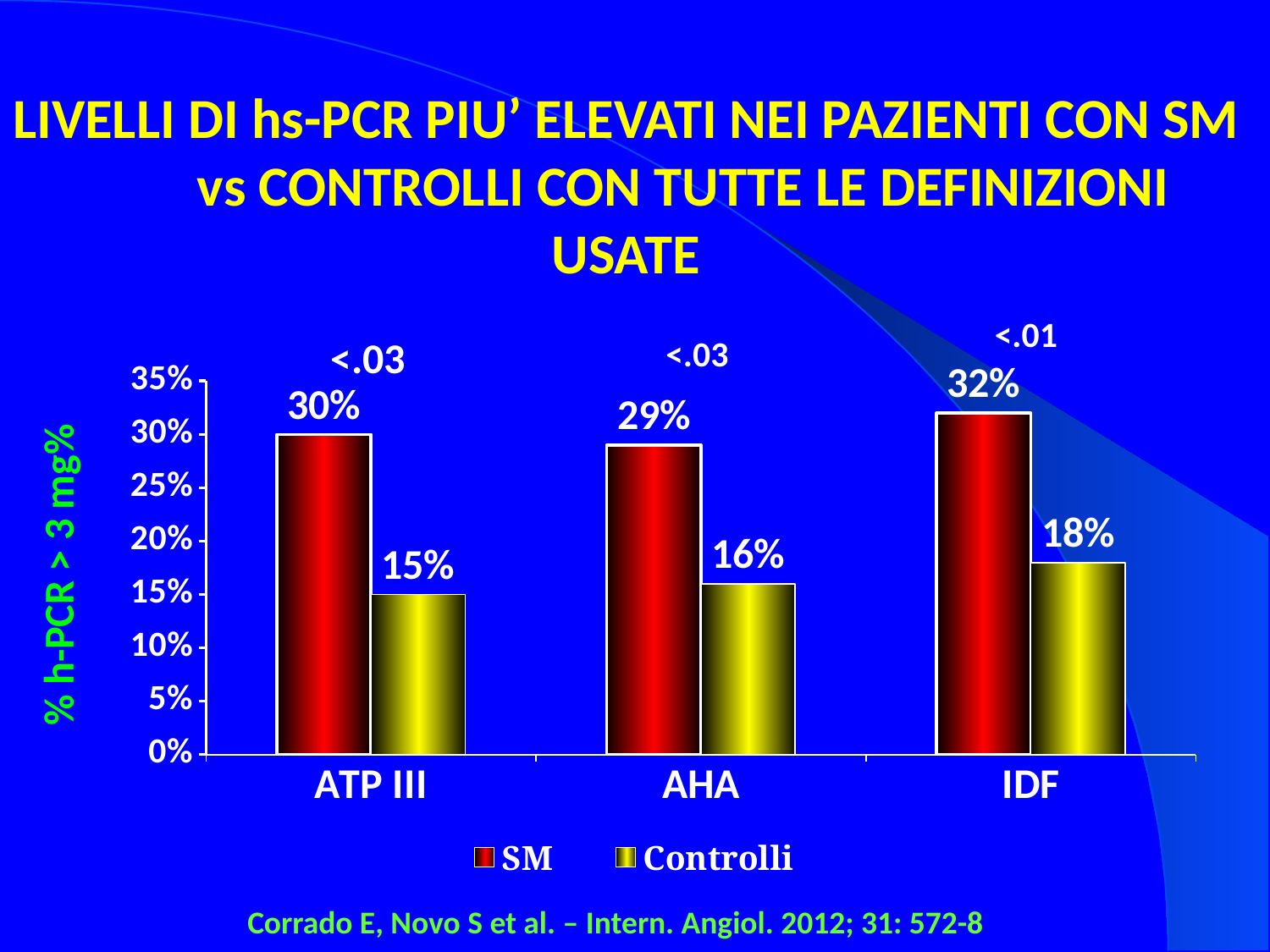
What is the value for Controlli in the AHA category? 16% How many series does the legend list? 2 In which category is the Controlli value lowest? ATP III What is the value for Controlli in the IDF category? 18% What is the difference between the SM and Controlli values in the ATP III category? 15% What is the value for SM in the IDF category? 32% What kind of chart is shown on the slide? bar chart What is the label of the y axis? % h-PCR > 3 mg% In which category is the SM value highest? IDF What is the value for SM in the ATP III category? 30% How many categories are shown on the x axis? 3 Which is larger in the AHA category, the SM value or the Controlli value? SM